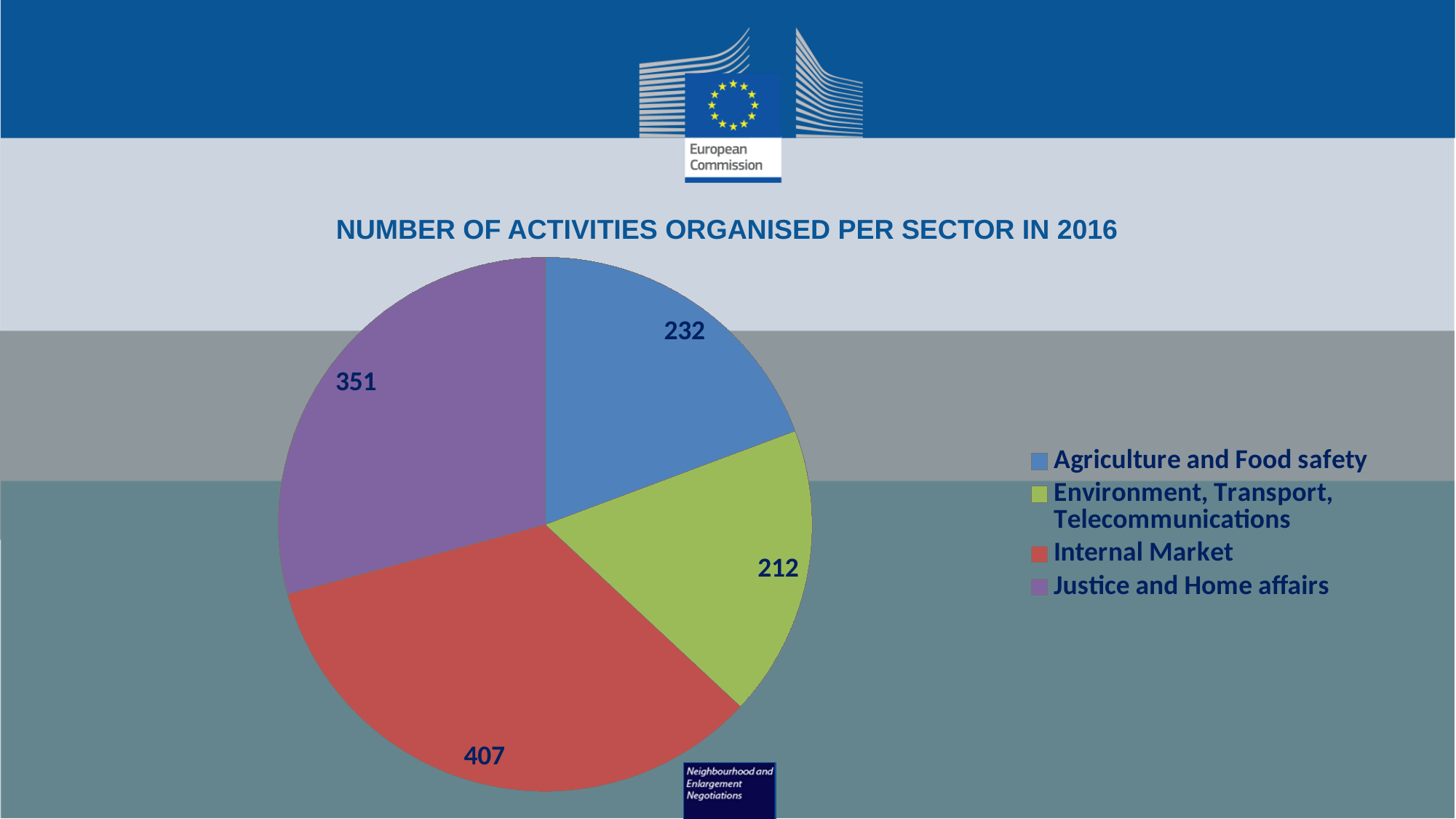
How many sectors are shown in the pie chart? 4 What is the difference between the number of activities for Internal Market and Justice and Home affairs? 56 How many activities were organised in the Agriculture and Food safety sector? 232 How many activities were organised in the Justice and Home affairs sector? 351 What is the title of the chart? NUMBER OF ACTIVITIES ORGANISED PER SECTOR IN 2016 Which sector had the lowest number of activities? Environment, Transport, Telecommunications Which sector had more activities, Agriculture and Food safety or Environment, Transport, Telecommunications? Agriculture and Food safety What colour represents Justice and Home affairs in the chart? Purple How many activities were organised in the Environment, Transport, Telecommunications sector? 212 What type of chart is shown on the slide? Pie chart How many activities were organised in the Internal Market sector? 407 Which sector had the highest number of activities? Internal Market